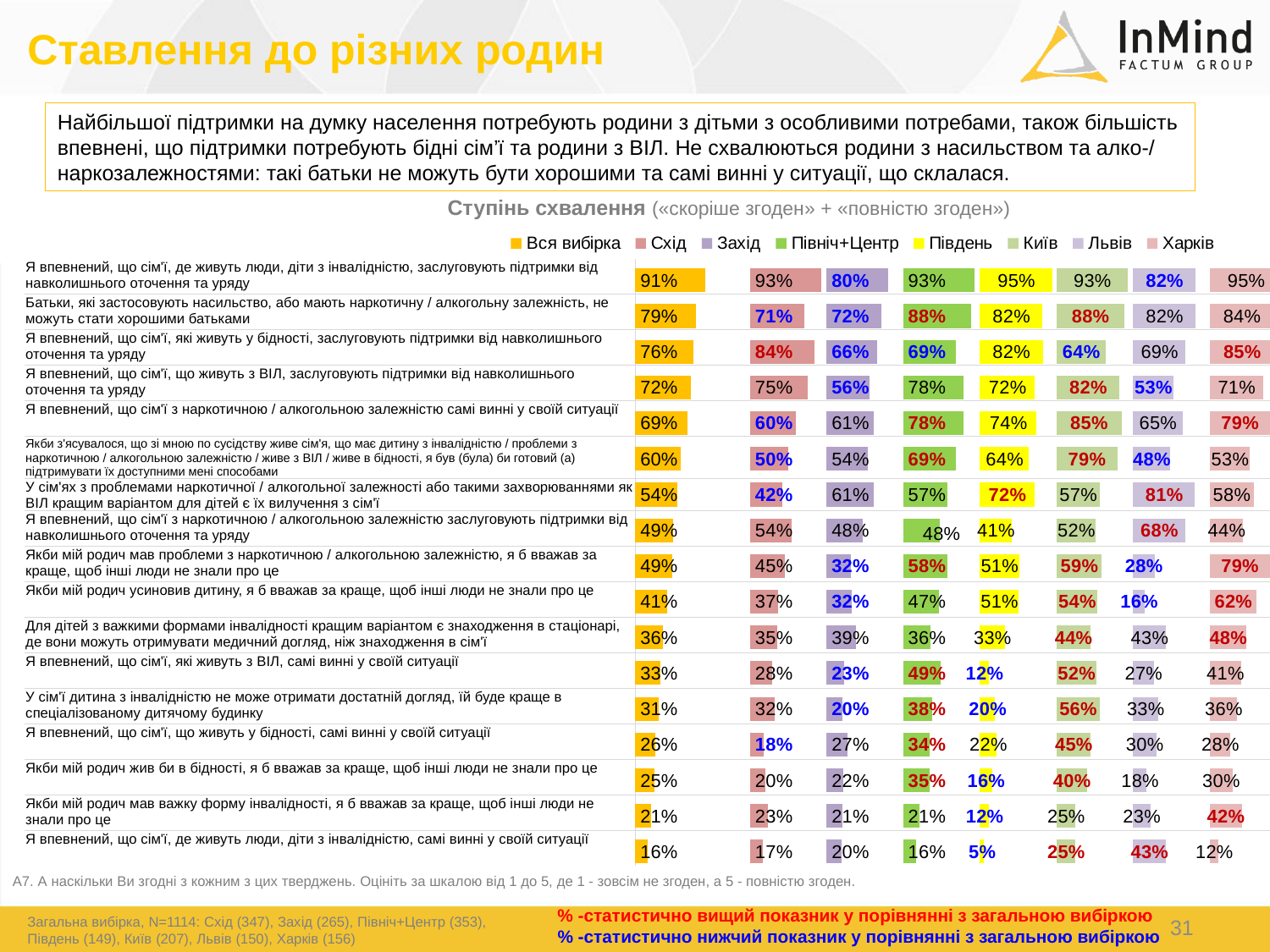
Which series has the lowest value for the statement «Я впевнений, що сім'ї, де живуть люди, діти з інвалідністю, заслуговують підтримки від навколишнього оточення та уряду»? Захід What is the value for Львів on the statement «Я впевнений, що сім'ї, де живуть люди, діти з інвалідністю, самі винні у своїй ситуації»? 43% What is the value for Вся вибірка on the statement «Я впевнений, що сім'ї, де живуть люди, діти з інвалідністю, заслуговують підтримки від навколишнього оточення та уряду»? 91% Which series has the highest value for the statement «Якби мій родич усиновив дитину, я б вважав за краще, щоб інші люди не знали про це»? Харків How many statements (rows) are shown in the chart? 17 What is the value for Південь on the statement «Я впевнений, що сім'ї, де живуть люди, діти з інвалідністю, самі винні у своїй ситуації»? 5% What is the title of the chart? Ступінь схвалення What kind of chart is shown on the slide? Bar chart For Вся вибірка, what is the difference between the value for «сім'ї, де живуть люди, діти з інвалідністю, заслуговують підтримки» (91%) and «сім'ї, де живуть люди, діти з інвалідністю, самі винні у своїй ситуації» (16%)? 75 percentage points How many series does the legend list? 8 Which series has the lowest value for the statement «Якби мій родич усиновив дитину, я б вважав за краще, щоб інші люди не знали про це»? Львів For the statement «Я впевнений, що сім'ї, що живуть з ВІЛ, заслуговують підтримки від навколишнього оточення та уряду», which is larger: Київ or Схід? Київ